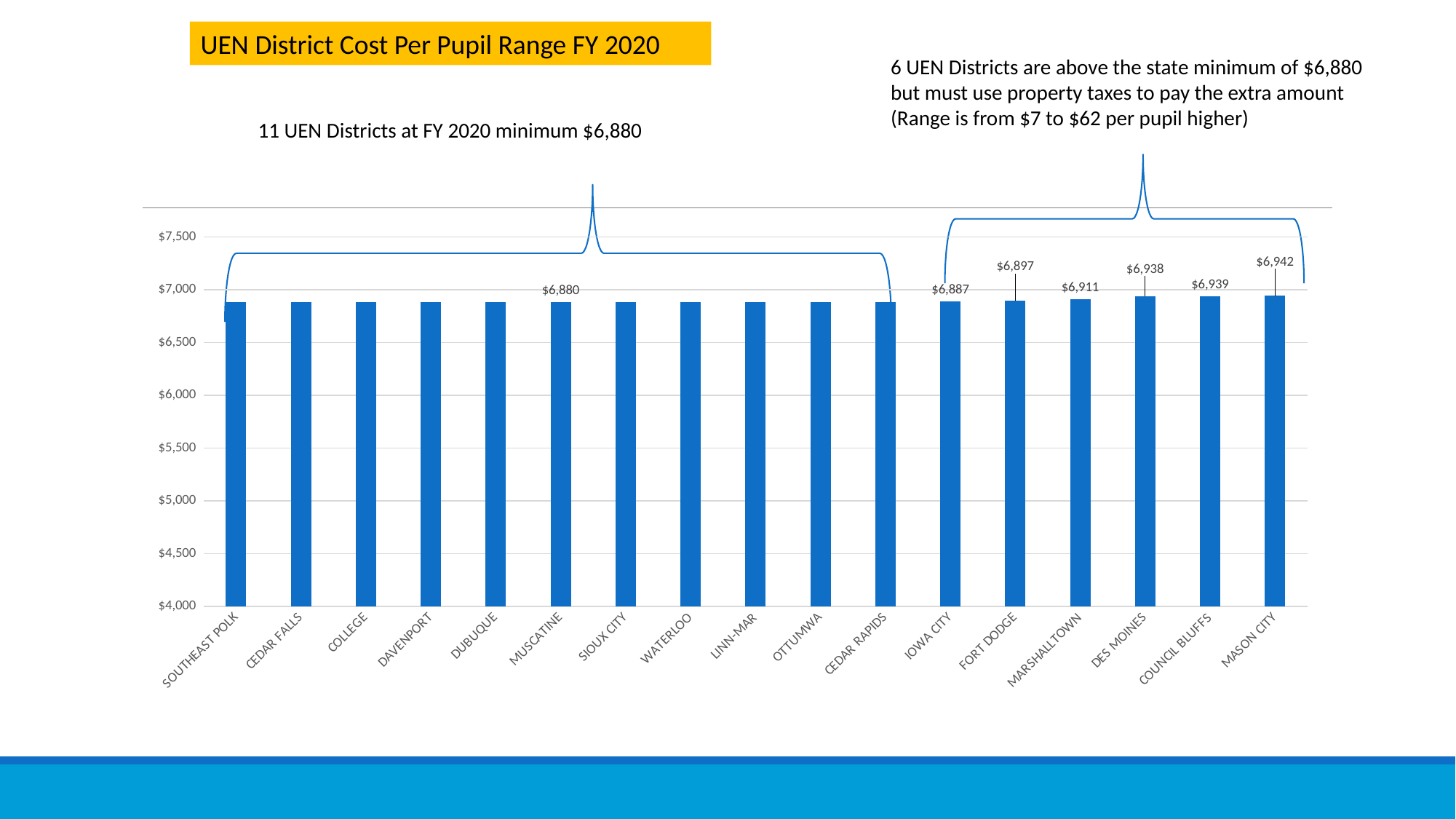
What is the cost per pupil for Marshalltown? $6,911 Which district has the highest cost per pupil? Mason City What kind of chart is shown on the slide? bar chart Is the value for Davenport greater or less than $6,500? greater What is the cost per pupil for Mason City? $6,942 What is the title of the chart on the slide? UEN District Cost Per Pupil Range FY 2020 How many districts are shown on the x axis of the chart? 17 Which has a higher cost per pupil, Des Moines or Fort Dodge? Des Moines What is the cost per pupil for Fort Dodge? $6,897 What is the cost per pupil for Iowa City? $6,887 What is the difference in cost per pupil between Mason City and Iowa City? $55 What is the difference in cost per pupil between Marshalltown and Fort Dodge? $14